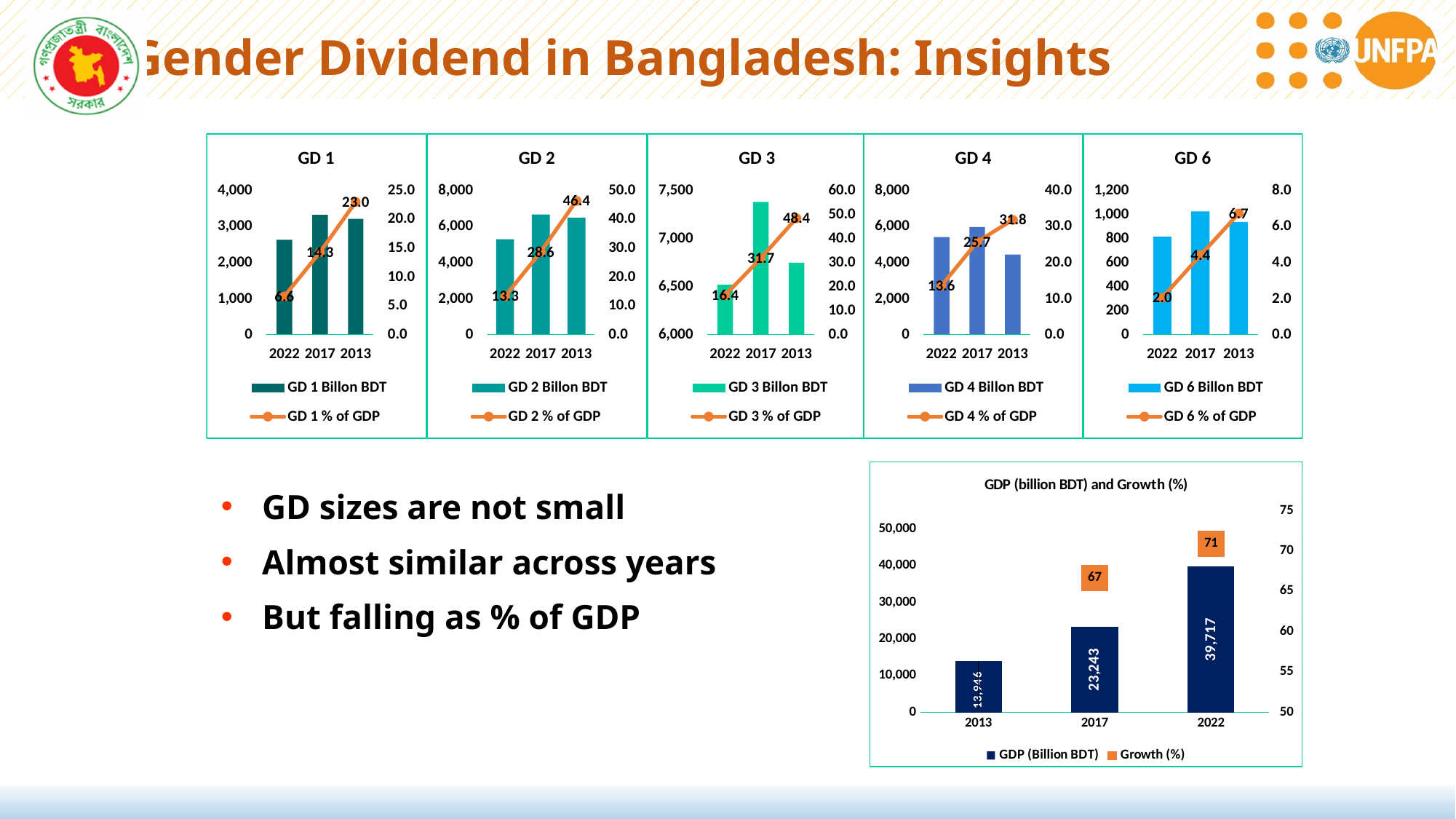
In the GD 2 chart, what is the GD 2 % of GDP value for 2013? 46.4 In the GD 1 chart, what is the difference between the GD 1 % of GDP values for 2013 and 2022? 16.4 In the GDP (billion BDT) and Growth (%) chart, what is the difference between the GDP values for 2022 and 2017? 16,474 In the GDP (billion BDT) and Growth (%) chart, what is the Growth (%) value for 2017? 67 In the GD 4 chart, is the GD 4 Billon BDT bar for 2013 greater or less than 6,000? less In the GD 3 chart, what is the GD 3 % of GDP value for 2017? 31.7 In the GD 2 chart, does the GD 2 % of GDP line rise or fall moving left to right across the x axis? rise In the GDP (billion BDT) and Growth (%) chart, what is the GDP value for 2022? 39,717 In the GD 1 chart, what is the GD 1 % of GDP value for 2022? 6.6 In the GD 4 chart, what is the GD 4 % of GDP value for 2022? 13.6 In the GD 6 chart, what is the GD 6 % of GDP value for 2013? 6.7 In the GD 3 chart, which year has the tallest GD 3 Billon BDT bar? 2017